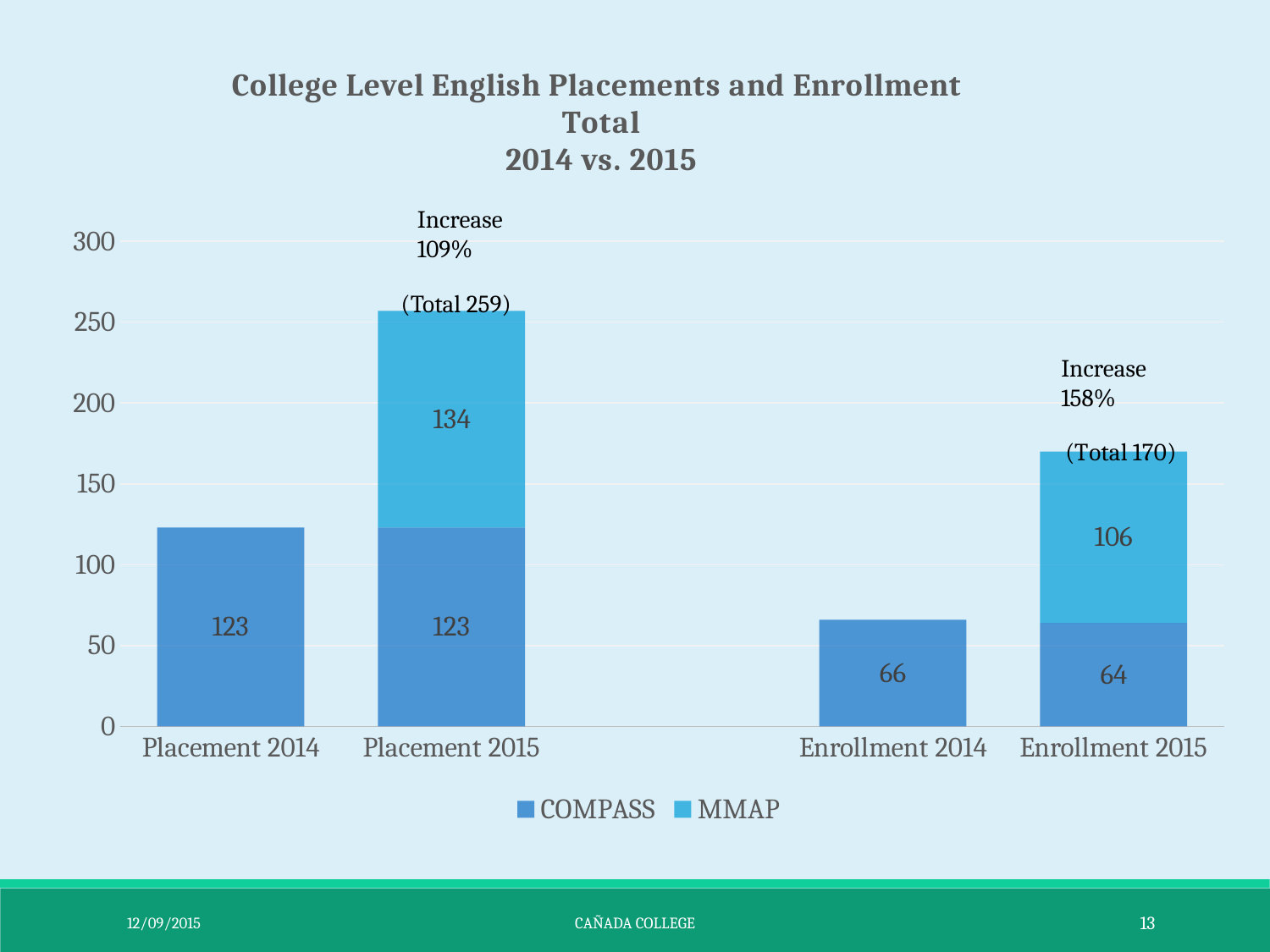
What kind of chart is shown on the slide? Stacked bar chart How many series does the legend list? 2 What is the COMPASS value for Enrollment 2014? 66 What percentage increase is annotated above the Enrollment 2015 bar? 158% What is the total of the stacked bar for Enrollment 2015? 170 What is the total of the stacked bar for Placement 2015? 259 What is the MMAP value for Placement 2015? 134 What is the difference between the COMPASS values for Enrollment 2014 and Enrollment 2015? 2 What is the COMPASS value for Placement 2014? 123 Which category has the lowest COMPASS value? Enrollment 2015 Is the MMAP value for Placement 2015 larger than the MMAP value for Enrollment 2015? Yes What is the MMAP value for Enrollment 2015? 106